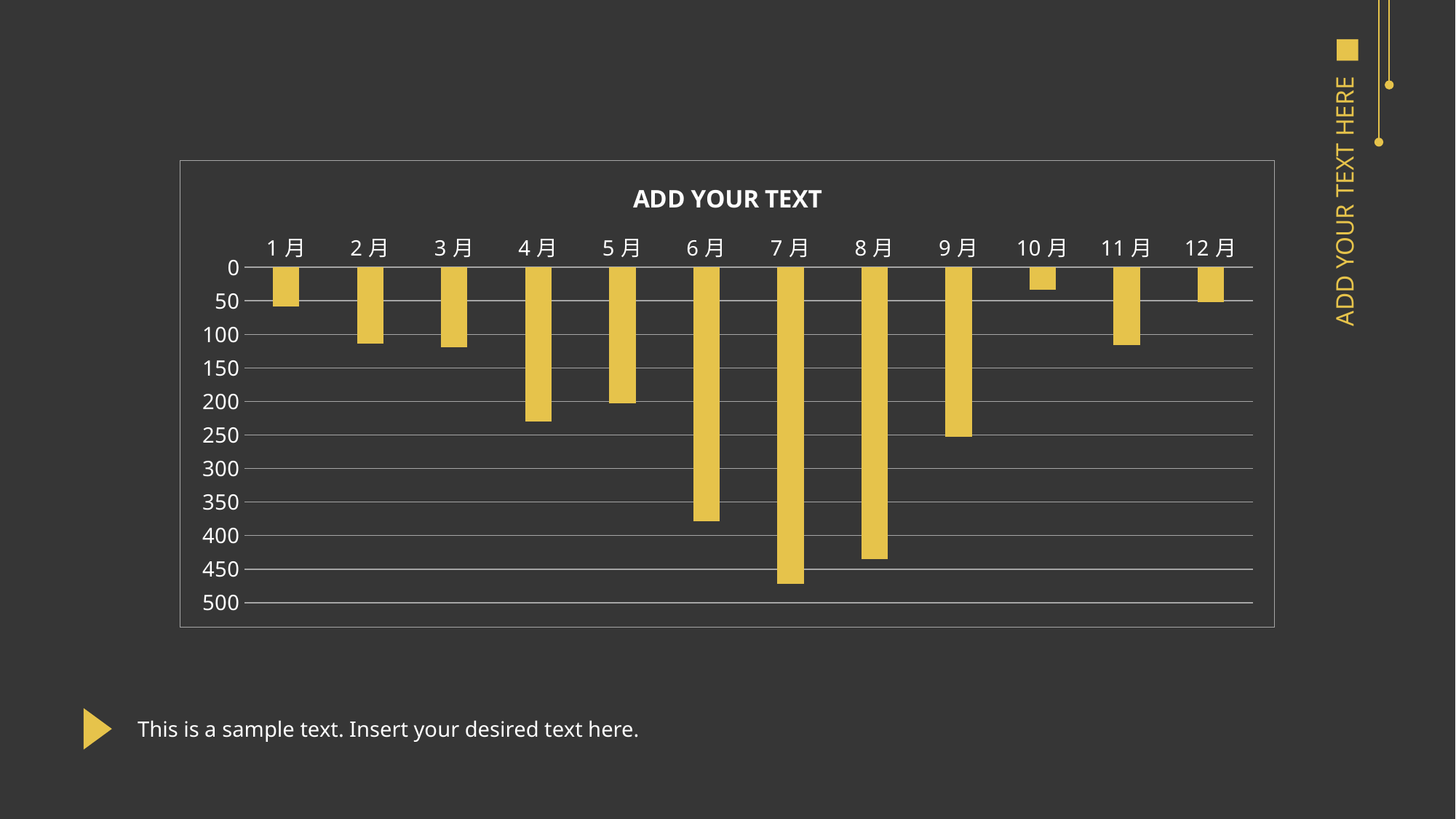
What is the title of the chart? ADD YOUR TEXT Which month has the shortest bar (lowest value) in the chart? 10月 Which month has the longest bar (highest value) in the chart? 7月 Is the value for 8月 greater or less than 400? greater How many categories (months) are shown on the x axis of the chart? 12 Is the value for 4月 greater or less than 200? greater Is the value for 6月 greater or less than 350? greater Which has the larger value, 6月 or 9月? 6月 Do the bar values increase or decrease from 1月 to 7月? increase Which has the larger value, 7月 or 8月? 7月 What type of chart is shown on the slide? bar chart